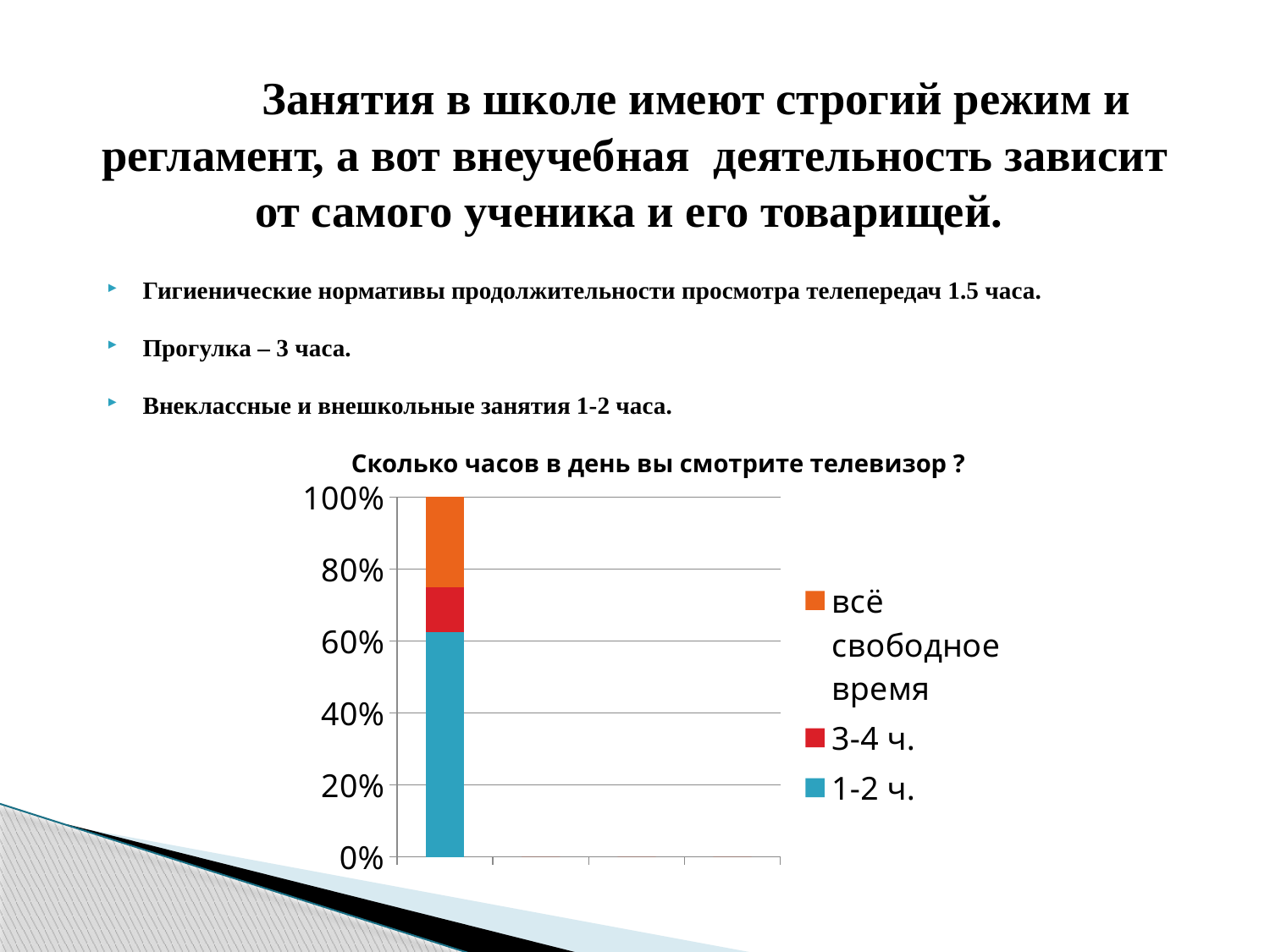
Which series takes up the smallest share of the bar? 3-4 ч. Is the share for "1-2 ч." greater or less than 80%? less Is the share for "1-2 ч." greater or less than 40%? greater Which series is shown in blue in the chart? 1-2 ч. What is the title of the chart? Сколько часов в день вы смотрите телевизор ? What value does the top of the stacked bar reach on the vertical axis? 100% Which segment is larger: "1-2 ч." or "всё свободное время"? 1-2 ч. How many series does the chart legend list? 3 Is the share for "3-4 ч." greater or less than 20%? less Which series takes up the largest share of the bar? 1-2 ч. How many bars are plotted in the chart? 1 What kind of chart is shown on the slide? stacked bar chart